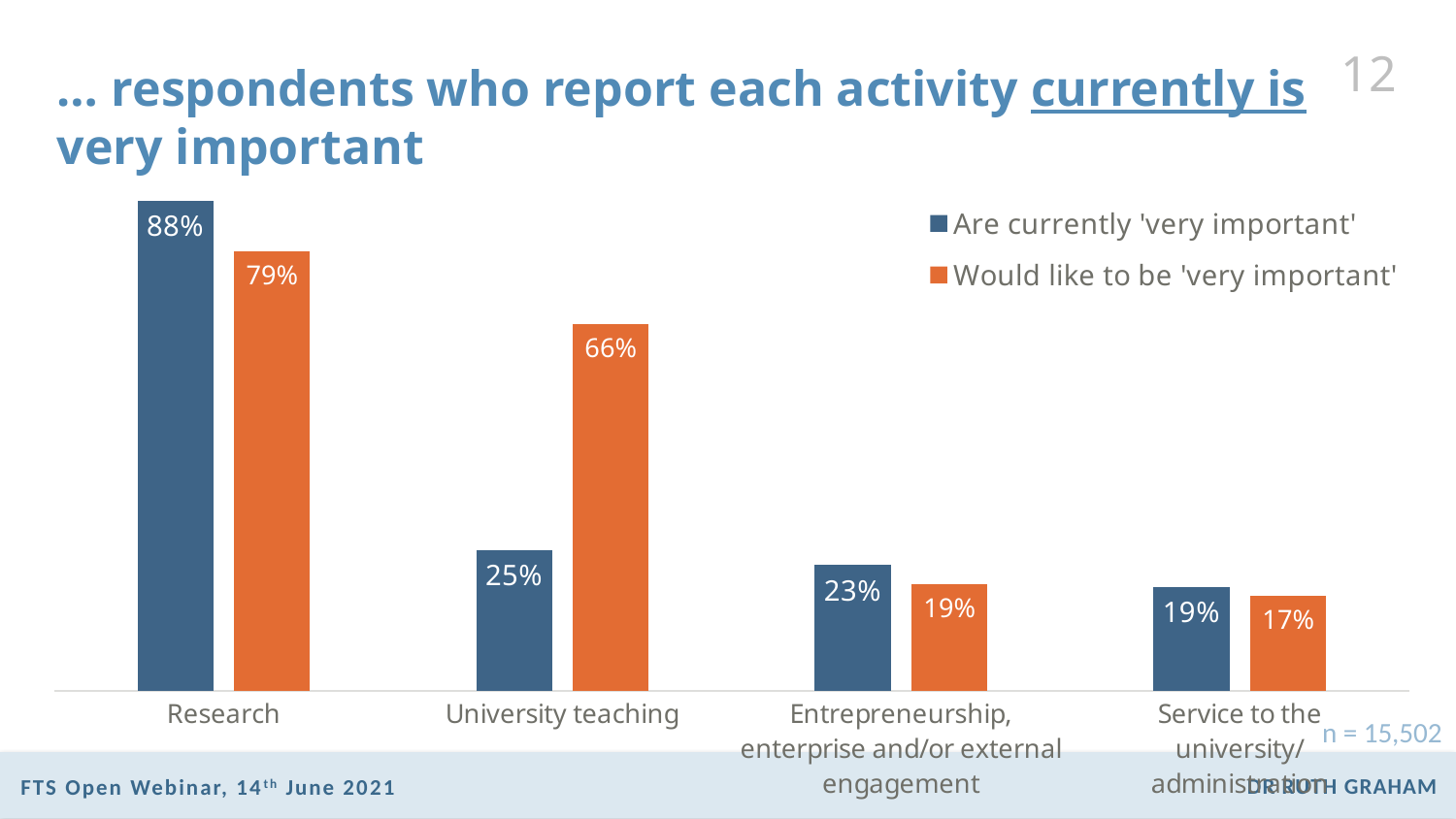
For Entrepreneurship, enterprise and/or external engagement, which is larger: the share who say it is currently 'very important' or the share who would like it to be 'very important'? Are currently 'very important' What is the value for 'Would like to be very important' for Service to the university/administration? 17% What percentage of respondents would like University teaching to be 'very important'? 66% What is the difference between the 'Are currently very important' and 'Would like to be very important' values for University teaching? 41 percentage points What percentage of respondents report that Research is currently 'very important'? 88% Which colour represents the 'Would like to be very important' series? Orange How many activity categories are shown on the chart? 4 What type of chart is shown on the slide? Bar chart Which activity has the lowest share of respondents who would like it to be 'very important'? Service to the university/administration What is the sample size (n) stated on the slide? n = 15,502 Which activity has the highest share of respondents reporting it is currently 'very important'? Research How many series does the legend list? 2